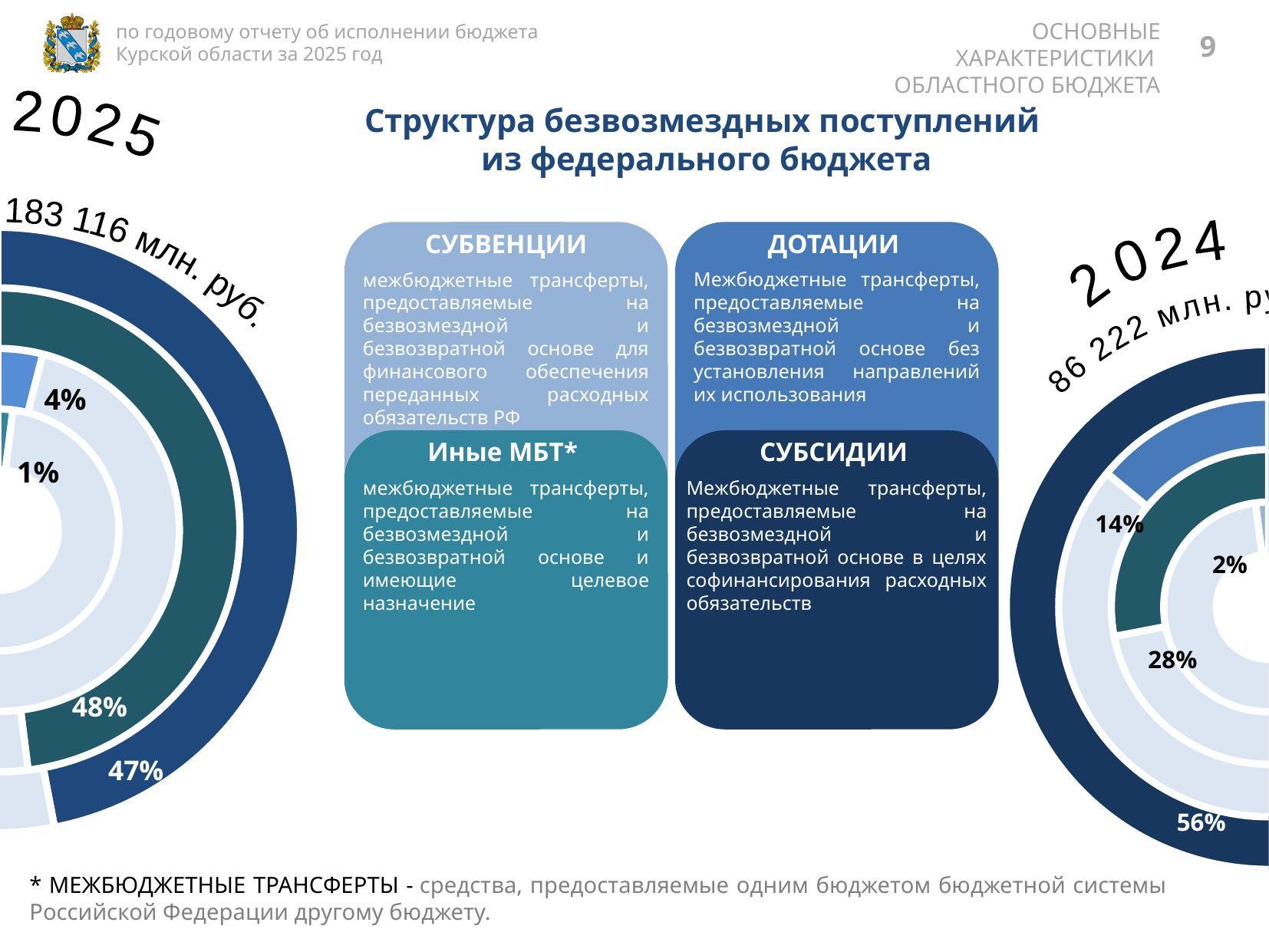
What is the largest percentage shown on the 2024 chart? 56% What number is shown next to the 2024 chart on the right? 86 222 Which is larger: the largest share on the 2024 chart or the largest share on the 2025 chart? The 2024 chart (56%) How many percentage labels are shown on the 2024 chart? 4 On the 2024 chart, what is the difference between the 56% share and the 28% share? 28 percentage points What is the smallest percentage shown on the 2025 chart? 1% What is the largest percentage shown on the 2025 chart? 48% What total amount is shown next to the 2025 chart? 183 116 млн. руб. What kind of chart is used to show the 2025 structure on the left of the slide? Doughnut (ring) chart What is the title of the slide's chart section? Структура безвозмездных поступлений из федерального бюджета How many percentage labels are shown on the 2025 chart? 4 What is the smallest percentage shown on the 2024 chart? 2%